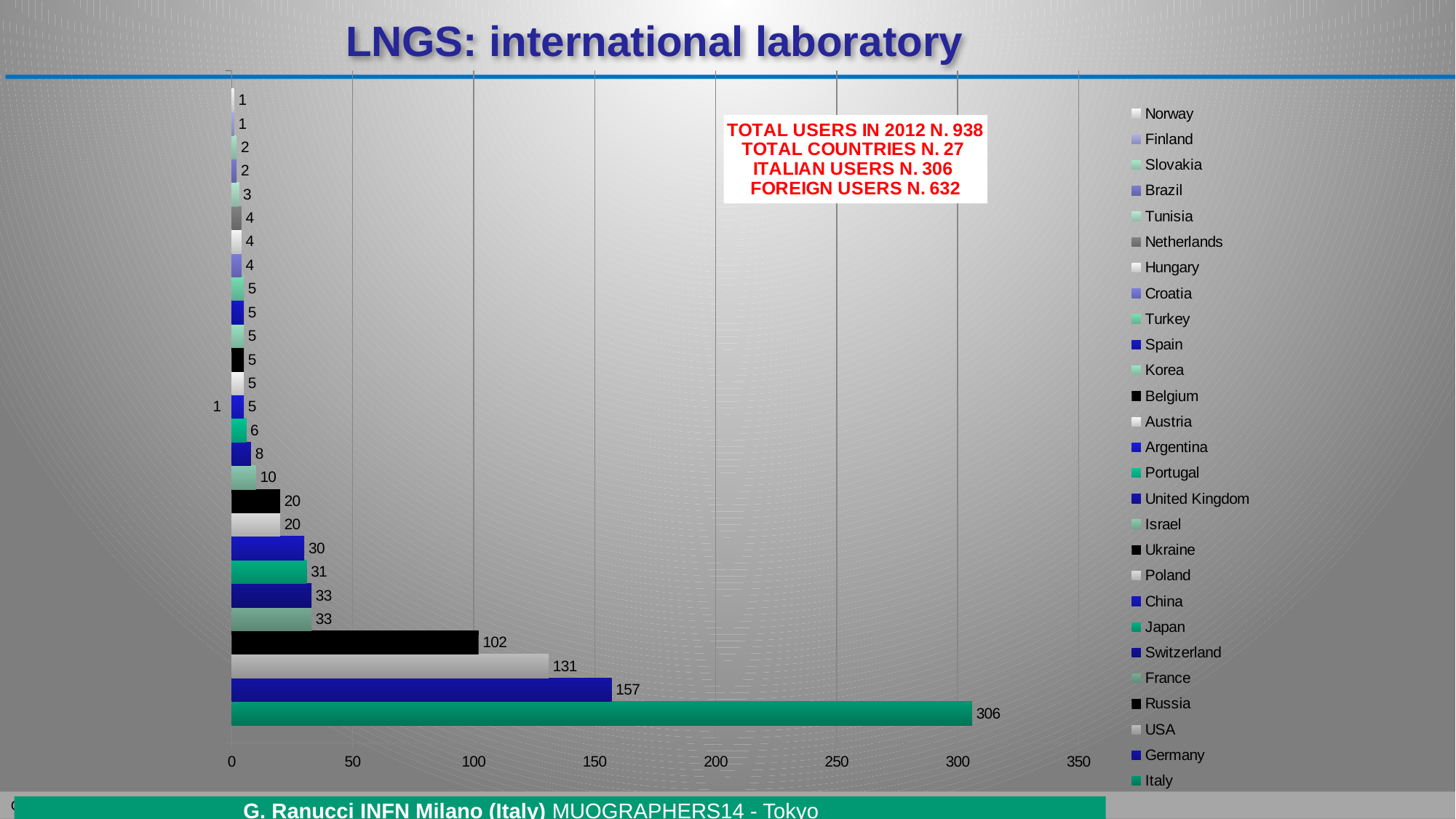
What kind of chart is shown on the slide? bar chart What is the value shown for the USA? 131 What is the difference between the values for Italy and Germany? 149 How many users does the bar for Italy show? 306 Which has a larger value, the USA or Russia? USA According to the text box on the chart, what was the total number of users in 2012? 938 What is the value shown for Russia? 102 How many countries are listed in the chart legend? 27 What is the difference between the values for Germany and the USA? 26 What is the title of the slide containing the chart? LNGS: international laboratory Which country has the highest value in the chart? Italy What is the value shown for Germany? 157